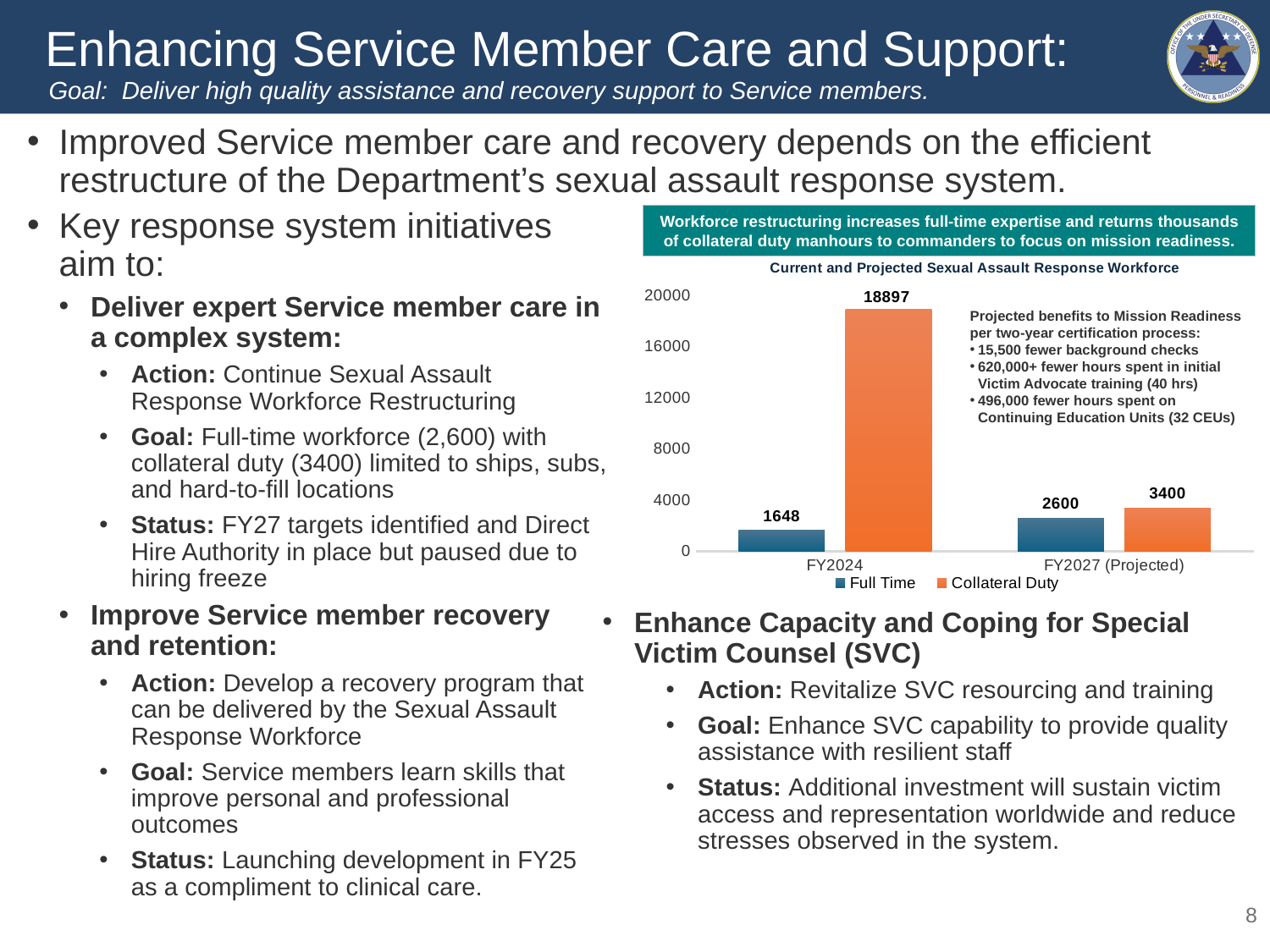
What is the Collateral Duty value for FY2027 (Projected)? 3400 What is the title of the chart? Current and Projected Sexual Assault Response Workforce Which bar has the highest value in the chart? Collateral Duty, FY2024 What is the Full Time value for FY2024? 1648 Which is larger for FY2027 (Projected): Full Time or Collateral Duty? Collateral Duty How many series does the legend list? 2 Which bar has the lowest value in the chart? Full Time, FY2024 What is the difference between the Collateral Duty values for FY2024 and FY2027 (Projected)? 15497 What is the Full Time value for FY2027 (Projected)? 2600 What kind of chart is shown on the slide? Bar chart What is the Collateral Duty value for FY2024? 18897 What is the difference between the Full Time values for FY2027 (Projected) and FY2024? 952